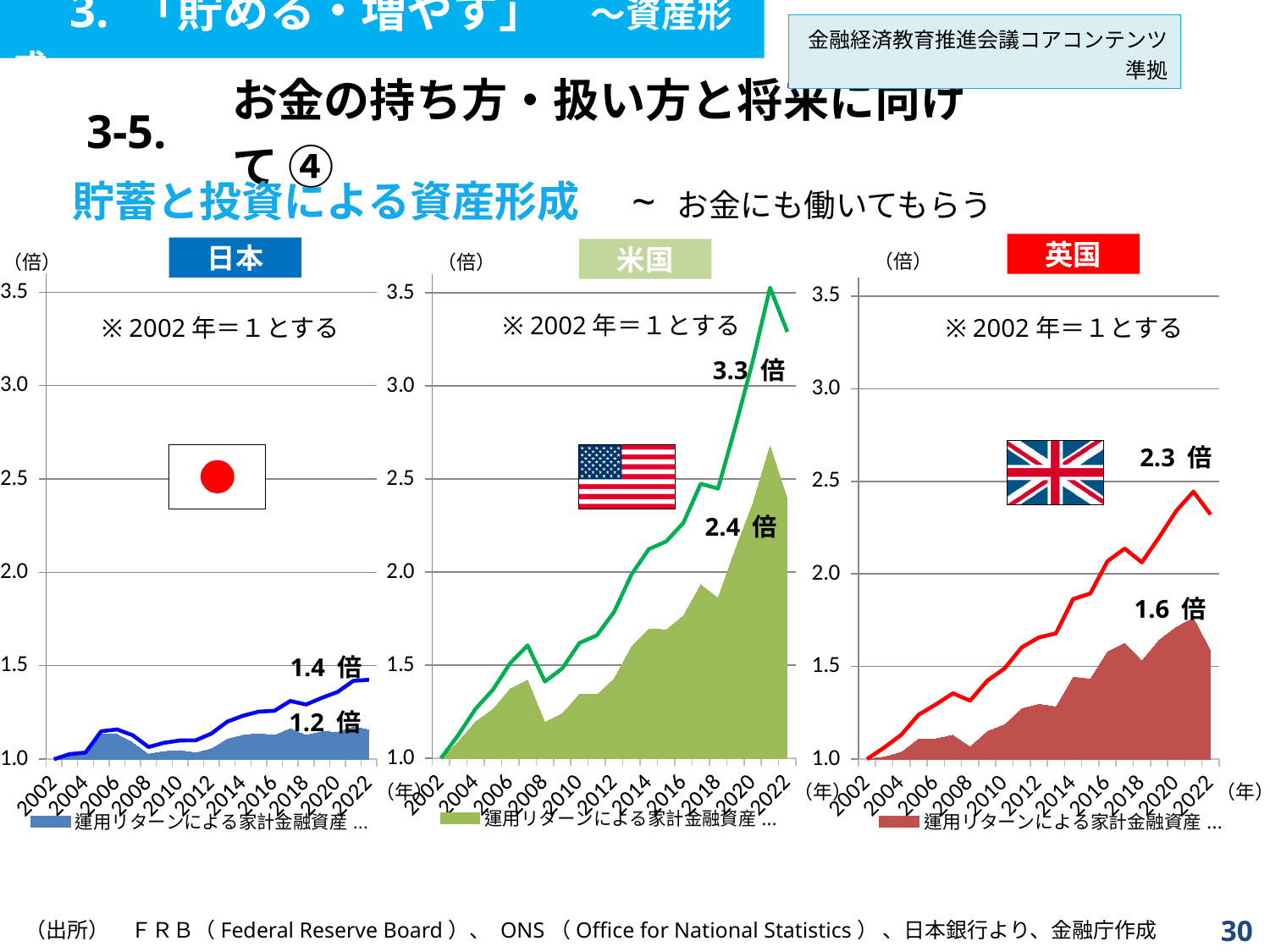
In the 日本 chart, what value is labelled on the shaded area series? 1.2 倍 In the 英国 chart, what value is labelled on the line series? 2.3 倍 In the 日本 chart, is the line value in 2022 greater or less than 1.5? less Across the three charts, which country's chart shows the highest labelled line value? 米国 In the 米国 chart, does the line series generally rise or fall from 2002 to 2022? rise In the 米国 chart, is the peak of the line series greater or less than 3.0? greater In the 米国 chart, what value is labelled on the line series? 3.3 倍 In the 米国 chart, what is the difference between the labelled line value (3.3 倍) and the labelled area value (2.4 倍)? 0.9 倍 What kind of chart is the 英国 chart? line and area chart Which is larger: the labelled line value in the 英国 chart or the labelled line value in the 日本 chart? 英国 In the 英国 chart, what value is labelled on the shaded area series? 1.6 倍 Across the three charts, which country's chart shows the lowest labelled line value? 日本